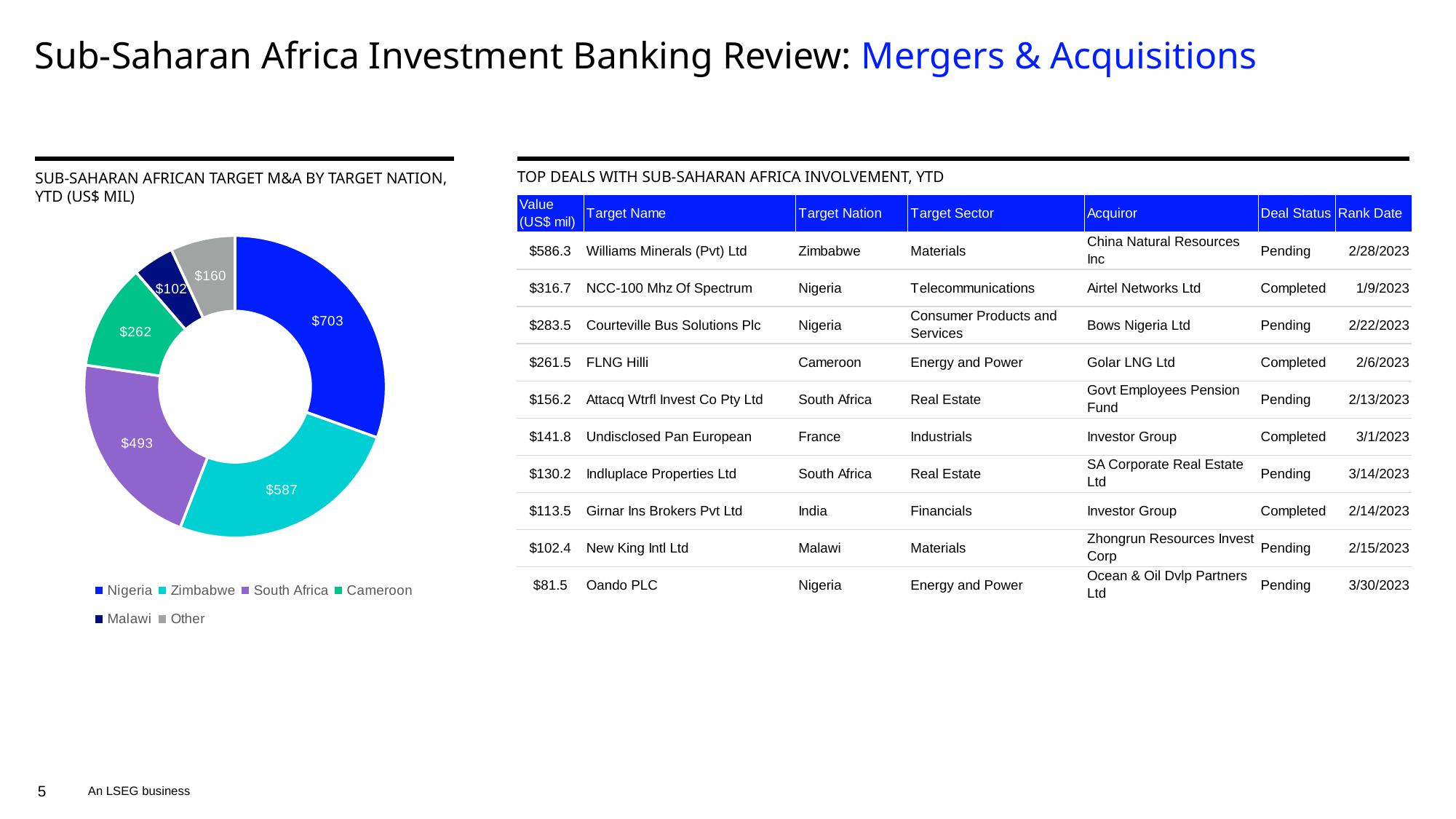
What is the value for Zimbabwe in the donut chart? $587 Which is larger in the donut chart, the value for Cameroon or the value for Other? Cameroon What kind of chart is shown on the slide? Donut (pie) chart How many categories does the donut chart show? 6 What is the value for Malawi in the donut chart? $102 What is the value for South Africa in the donut chart? $493 Which target nation has the lowest value in the donut chart? Malawi Which target nation has the highest value in the donut chart? Nigeria What is the value for Other in the donut chart? $160 What is the value for Cameroon in the donut chart? $262 What is the difference between the values for Nigeria and Zimbabwe in the donut chart? $116 What is the value for Nigeria in the Sub-Saharan African target M&A by target nation chart? $703